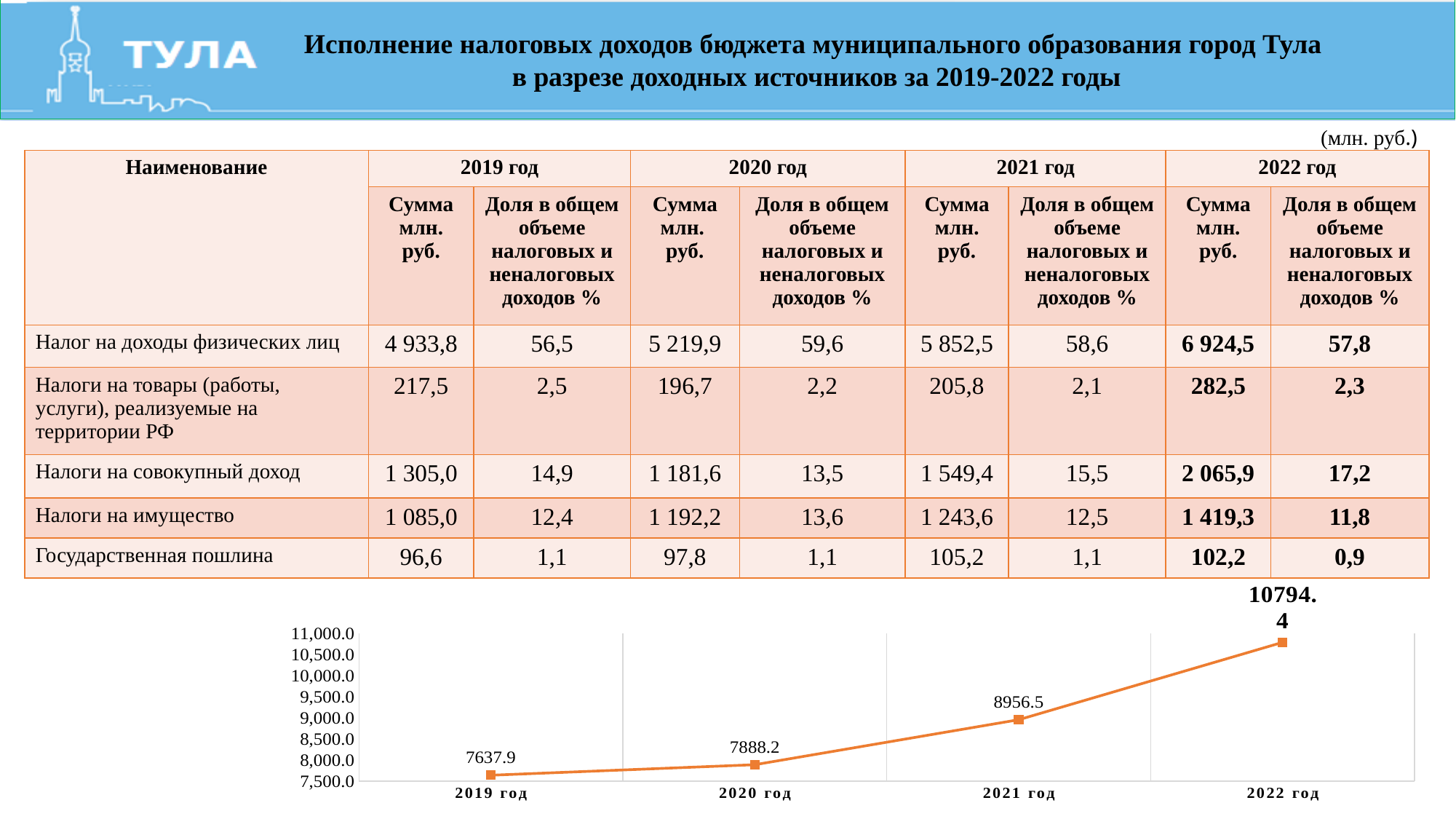
In the line chart, do the values rise or fall from 2019 год to 2022 год? rise How many data points are plotted in the line chart? 4 In the line chart, which year has the highest value? 2022 год What kind of chart is shown at the bottom of the slide? line chart In the line chart, what is the value for 2022 год? 10794.4 In the line chart, what is the difference between the values for 2020 год and 2019 год? 250.3 In the line chart, which is larger, the value for 2021 год or the value for 2020 год? 2021 год In the line chart, which year has the lowest value? 2019 год In the line chart, what is the value for 2020 год? 7888.2 In the line chart, what is the difference between the values for 2022 год and 2021 год? 1837.9 In the line chart, what is the value for 2021 год? 8956.5 In the line chart, what is the value for 2019 год? 7637.9